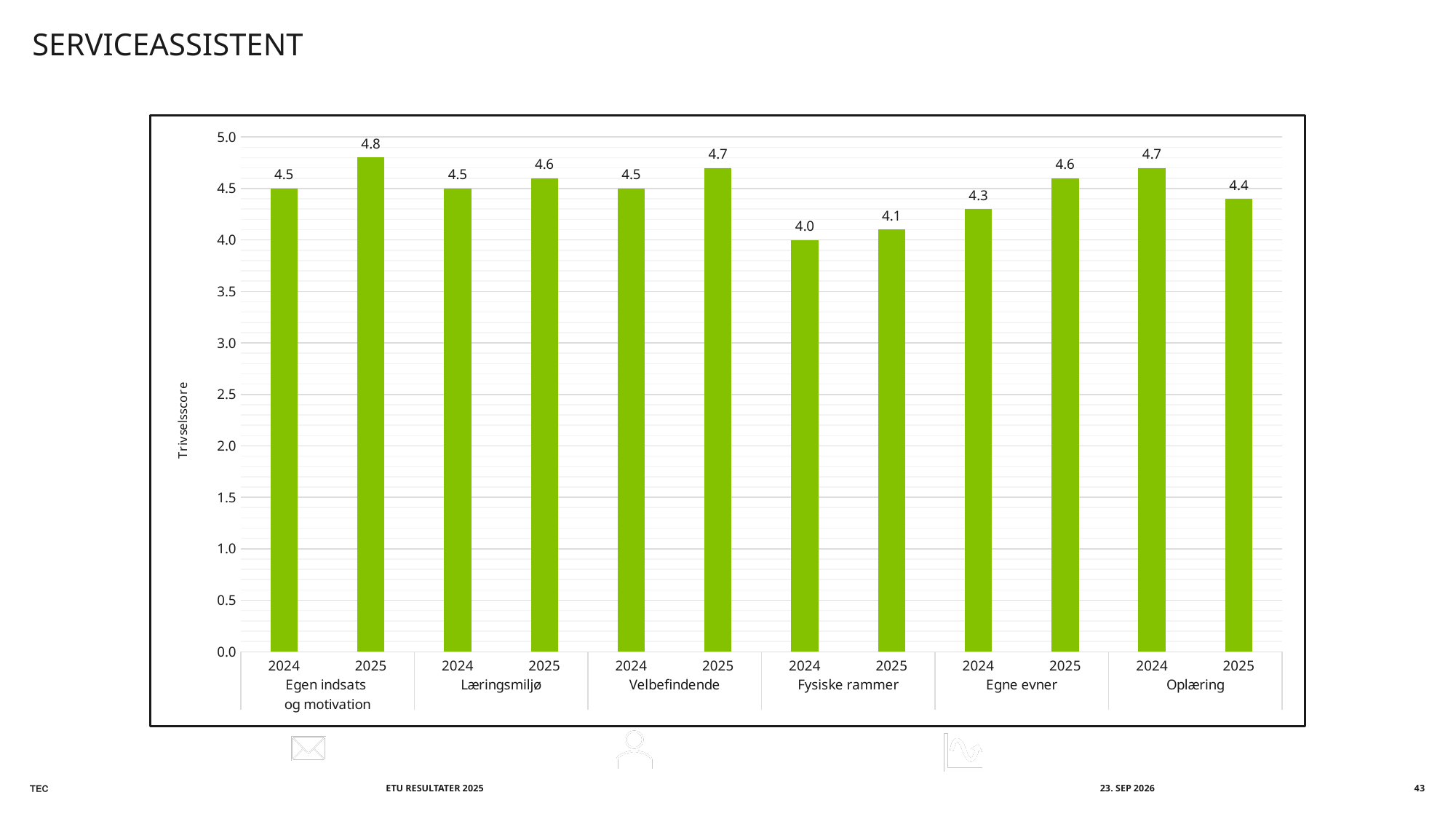
What is the value for Egne evner in 2024? 4.3 What is the value for Egen indsats og motivation in 2025? 4.8 What is the difference between the 2025 and 2024 values for Egen indsats og motivation? 0.3 How many bars are plotted on the chart? 12 What is the value for Fysiske rammer in 2024? 4.0 Is the value for Fysiske rammer in 2025 greater or less than 4.5? less What kind of chart is shown on the slide? bar chart Which is larger: Oplæring in 2024 or Oplæring in 2025? Oplæring in 2024 Which bar has the lowest value on the chart? Fysiske rammer 2024 What is the label of the vertical axis? Trivselsscore What is the value for Oplæring in 2025? 4.4 Which bar has the highest value on the chart? Egen indsats og motivation 2025